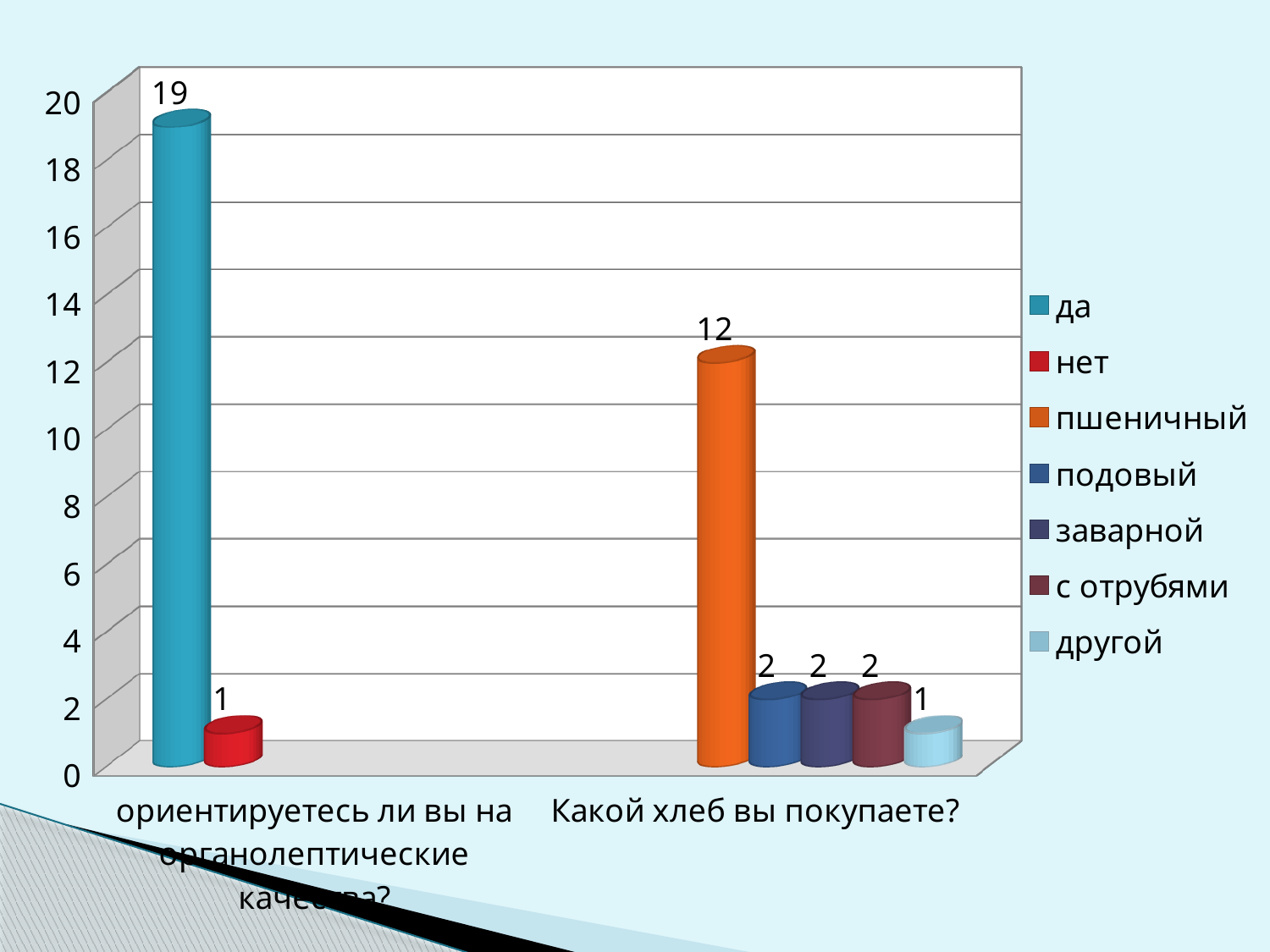
Which is larger, the value for "да" or the value for "пшеничный"? да What is the value for "пшеничный" in the category "Какой хлеб вы покупаете?"? 12 What is the value for "нет" in the category "ориентируетесь ли вы на органолептические качества?"? 1 What kind of chart is shown on the slide? bar chart What is the value for "другой" in the category "Какой хлеб вы покупаете?"? 1 Which series has the highest value on the chart? да Which series has the highest value in the category "Какой хлеб вы покупаете?"? пшеничный How many series does the legend list? 7 What is the difference between the values for "пшеничный" and "подовый"? 10 What is the value for "с отрубями" in the category "Какой хлеб вы покупаете?"? 2 What is the difference between the values for "да" and "нет"? 18 What is the value for "да" in the category "ориентируетесь ли вы на органолептические качества?"? 19